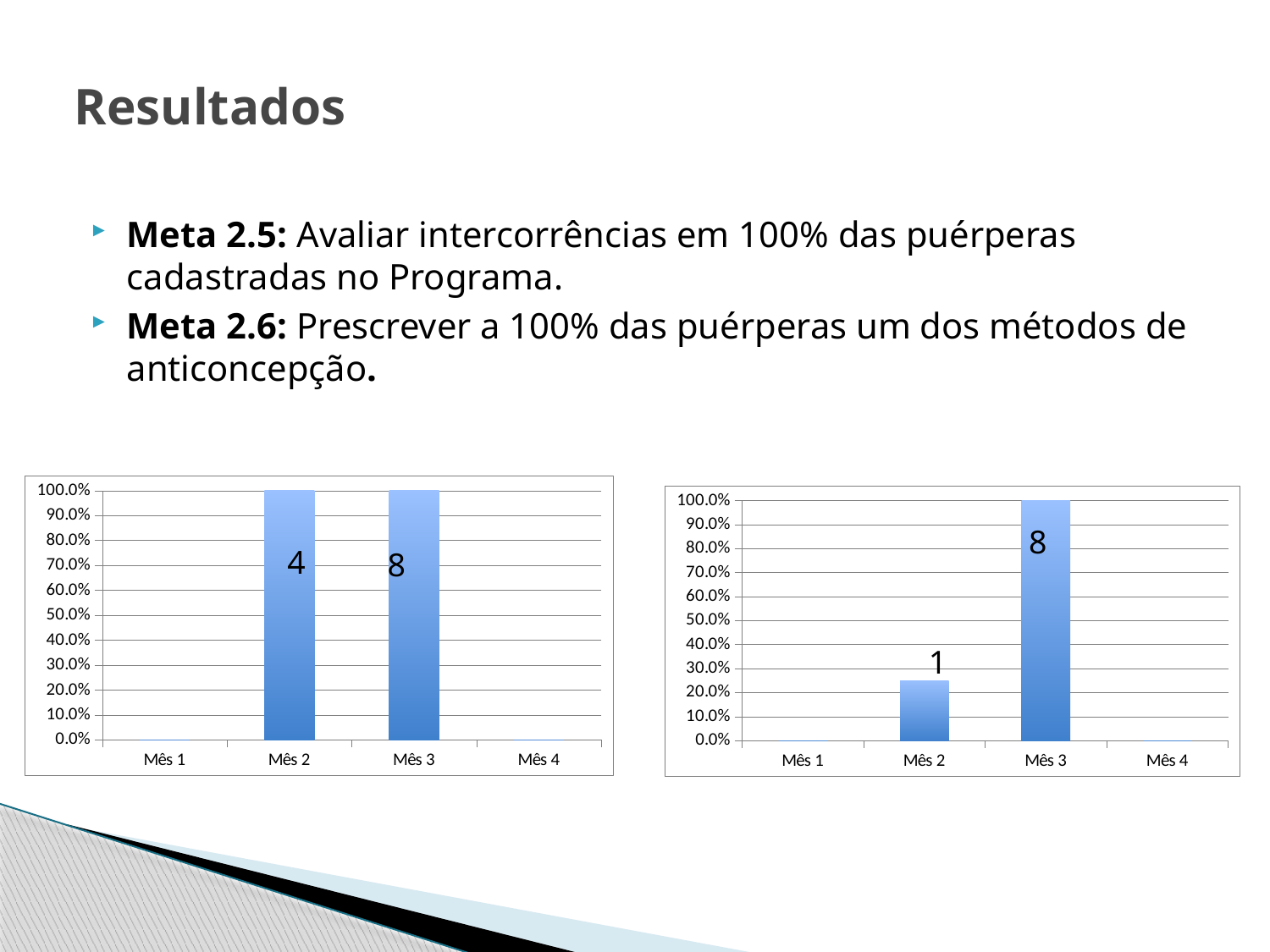
In the right chart, what percentage does the bar for Mês 3 reach? 100.0% In the right chart, what data label is printed on the bar for Mês 2? 1 In the left chart, what data label is printed on the bar for Mês 3? 8 In the right chart, is the value for Mês 2 greater or less than 50.0%? less In the right chart, which month has the highest bar? Mês 3 In the left chart, what is the highest value shown on the y axis? 100.0% In the right chart, is the value for Mês 2 greater or less than 20.0%? greater In the right chart, which bar is taller, Mês 2 or Mês 3? Mês 3 How many categories are shown on the x axis of the right chart? 4 In the right chart, what data label is printed on the bar for Mês 3? 8 In the left chart, what data label is printed on the bar for Mês 2? 4 What kind of chart is the left chart on the slide? bar chart